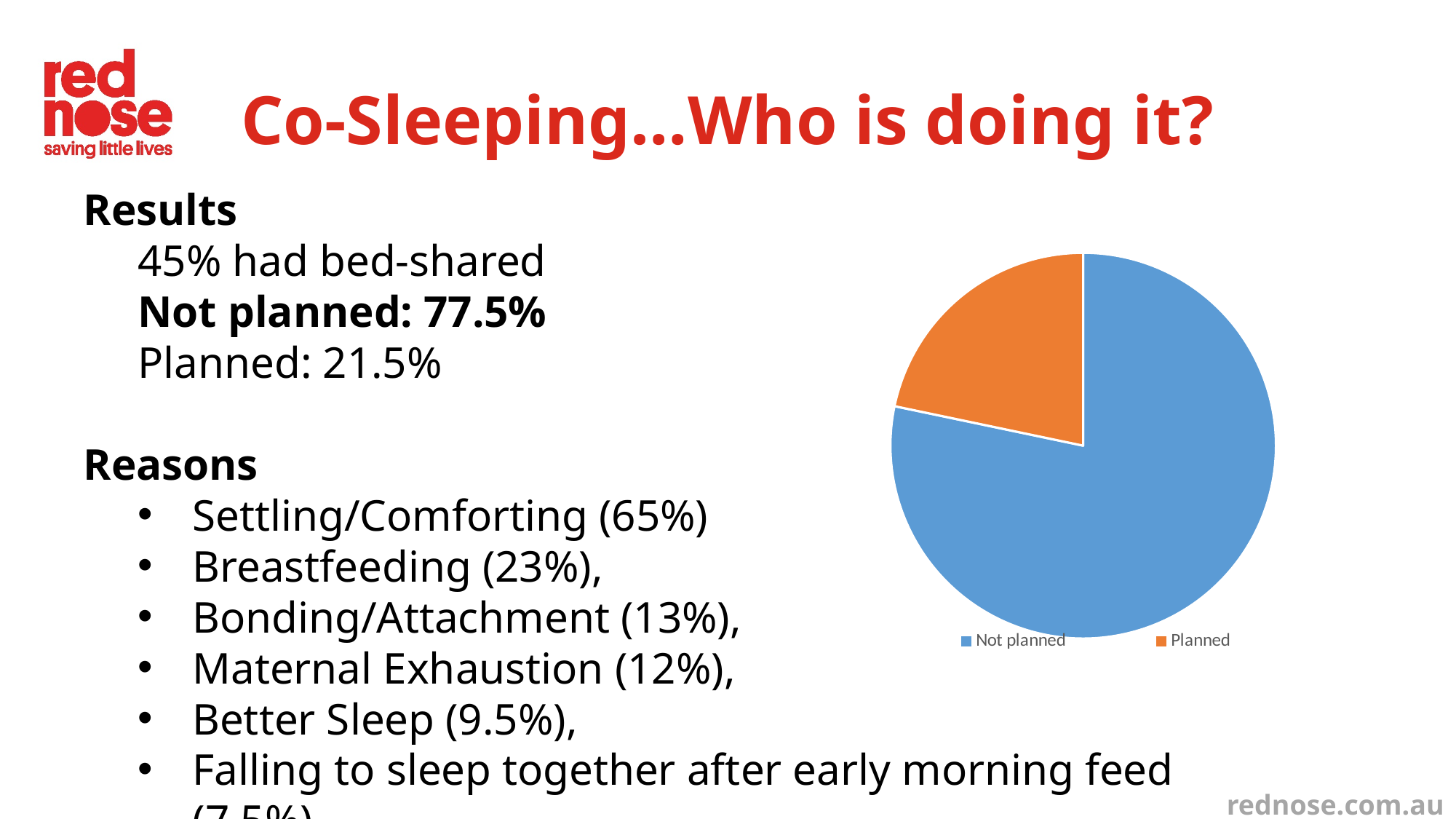
How many entries does the pie chart's legend list? 2 What colour is the Planned slice in the pie chart? orange What colour is the Not planned slice in the pie chart? blue Which slice of the pie chart is the smallest? Planned By how many percentage points does the Not planned share exceed the Planned share? 56 percentage points How many slices does the pie chart have? 2 Which slice of the pie chart is the largest? Not planned What kind of chart is shown on the slide? pie chart What share of the pie does the Not planned slice represent? 77.5% What share of the pie does the Planned slice represent? 21.5% Which is larger in the pie chart, Not planned or Planned? Not planned